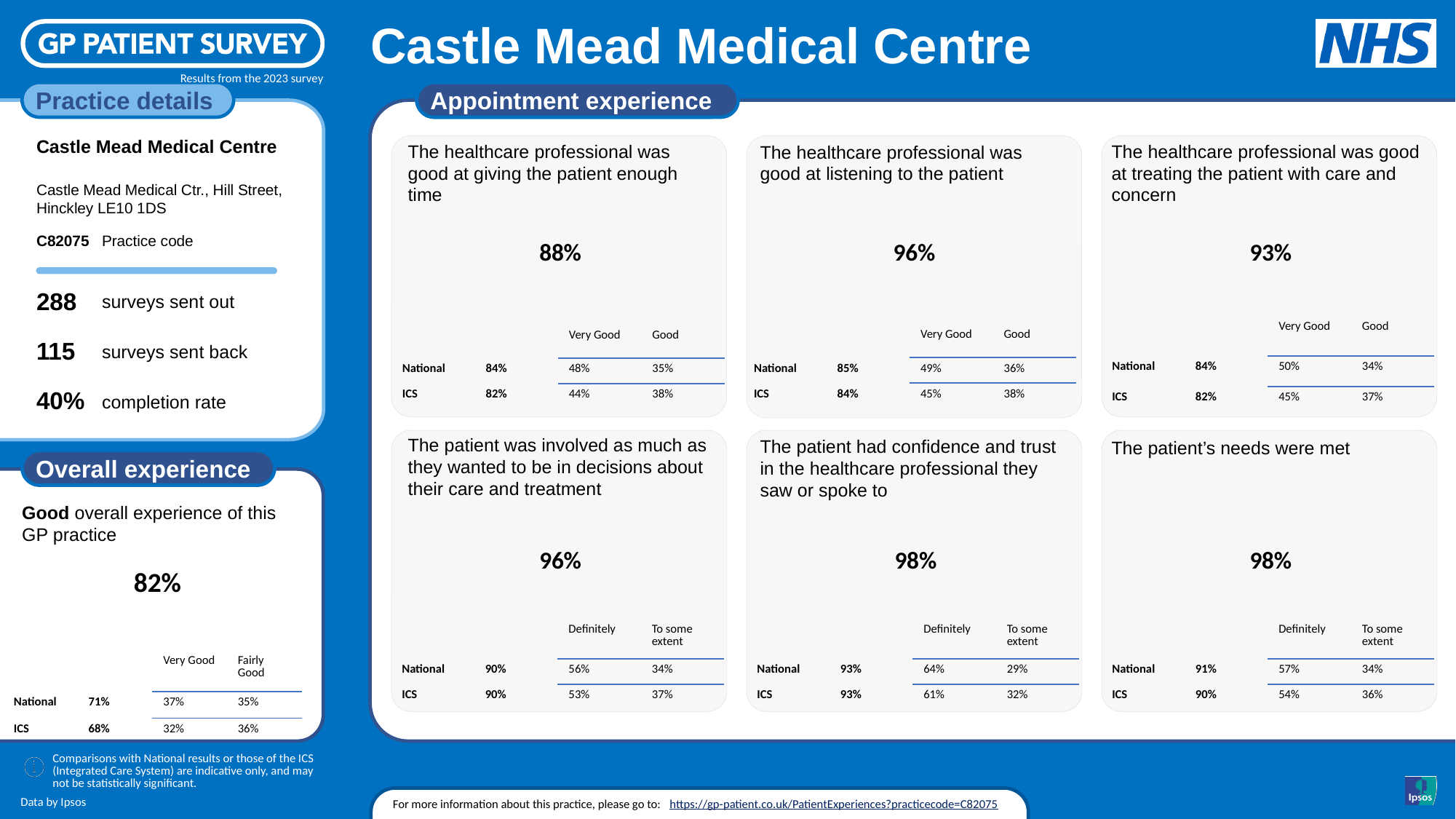
In the 'Overall experience' panel, how much higher is the practice's 82% than the ICS figure of 68%? 14 percentage points In the panel 'The patient's needs were met', which is larger: the practice's figure or the National figure? The practice's figure (98%) In the panel 'The healthcare professional was good at giving the patient enough time', what is the practice's percentage? 88% In the panel 'The healthcare professional was good at listening to the patient', what is the National 'Very Good' percentage? 49% In the panel 'The patient had confidence and trust in the healthcare professional they saw or spoke to', what is the National 'Definitely' percentage? 64% In the 'Overall experience' panel, what is the National figure for good overall experience? 71% In the panel 'The healthcare professional was good at treating the patient with care and concern', what is the ICS overall figure? 82% In the panel 'The patient was involved as much as they wanted to be in decisions about their care and treatment', what is the difference between the practice's 96% and the National 90%? 6 percentage points How many question panels are shown under the 'Appointment experience' heading? 6 In the 'Overall experience' panel, what percentage of patients reported a good overall experience of this GP practice? 82% Which of the six 'Appointment experience' panels shows the lowest practice percentage? The healthcare professional was good at giving the patient enough time (88%) In the 'Overall experience' panel, what is the ICS 'Very Good' percentage? 32%